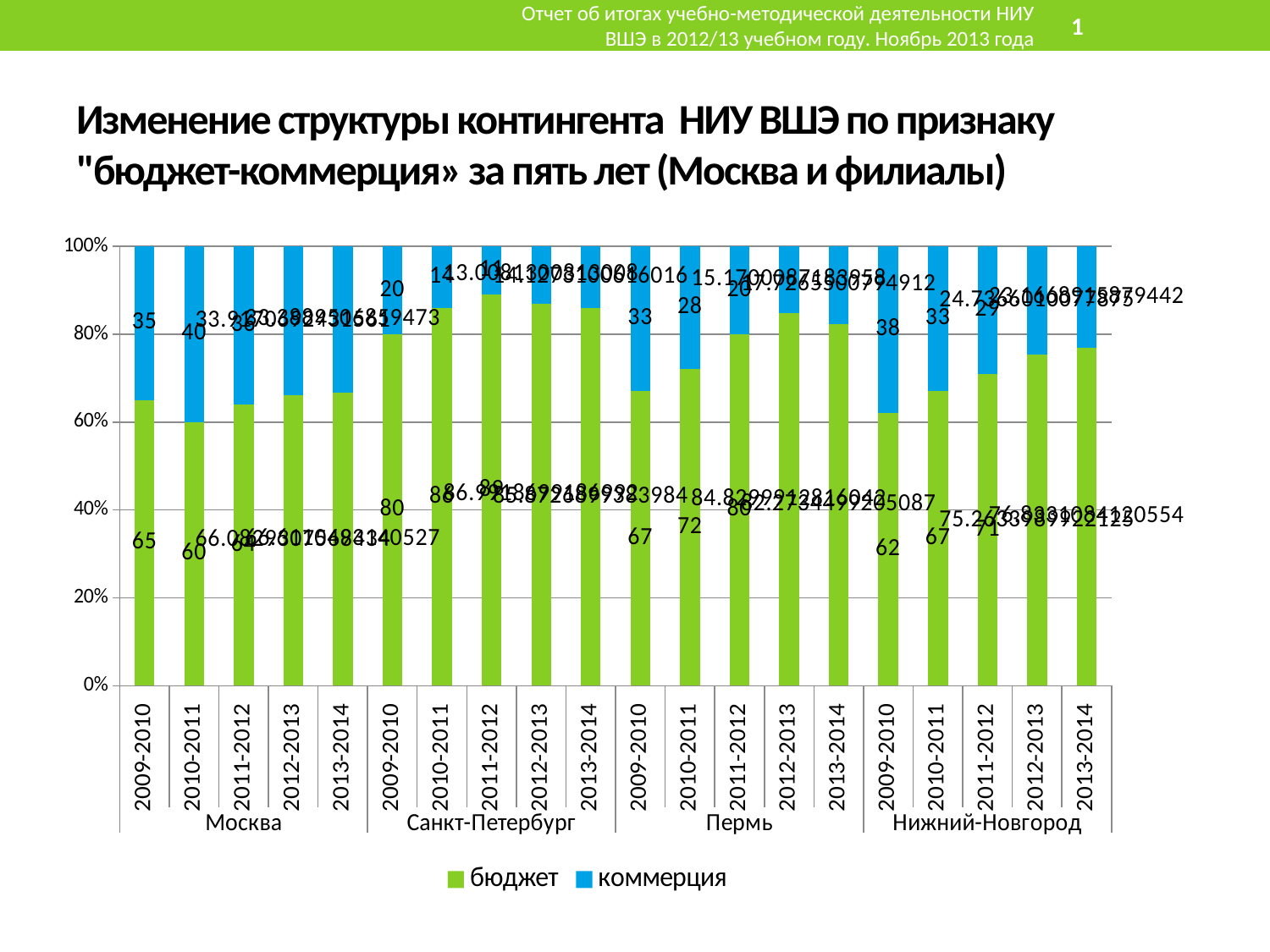
What is the бюджет value for Пермь in 2010-2011? 72 How many series does the legend list? 2 Is the бюджет share for Нижний-Новгород in 2013-2014 greater or less than 80%? less Is the бюджет share for Санкт-Петербург in 2011-2012 greater or less than 80%? greater What is the бюджет value for Москва in 2009-2010? 65 What is the коммерция value for Нижний-Новгород in 2009-2010? 38 Does the бюджет share for Нижний-Новгород rise or fall from 2009-2010 to 2013-2014? rise What is the difference between the бюджет and коммерция values for Пермь in 2009-2010? 34 What is the коммерция value for Санкт-Петербург in 2009-2010? 20 What is the коммерция value for Москва in 2010-2011? 40 What kind of chart is shown on the slide? Stacked bar chart Which is larger, the бюджет value for Пермь in 2010-2011 or the бюджет value for Москва in 2010-2011? Пермь in 2010-2011